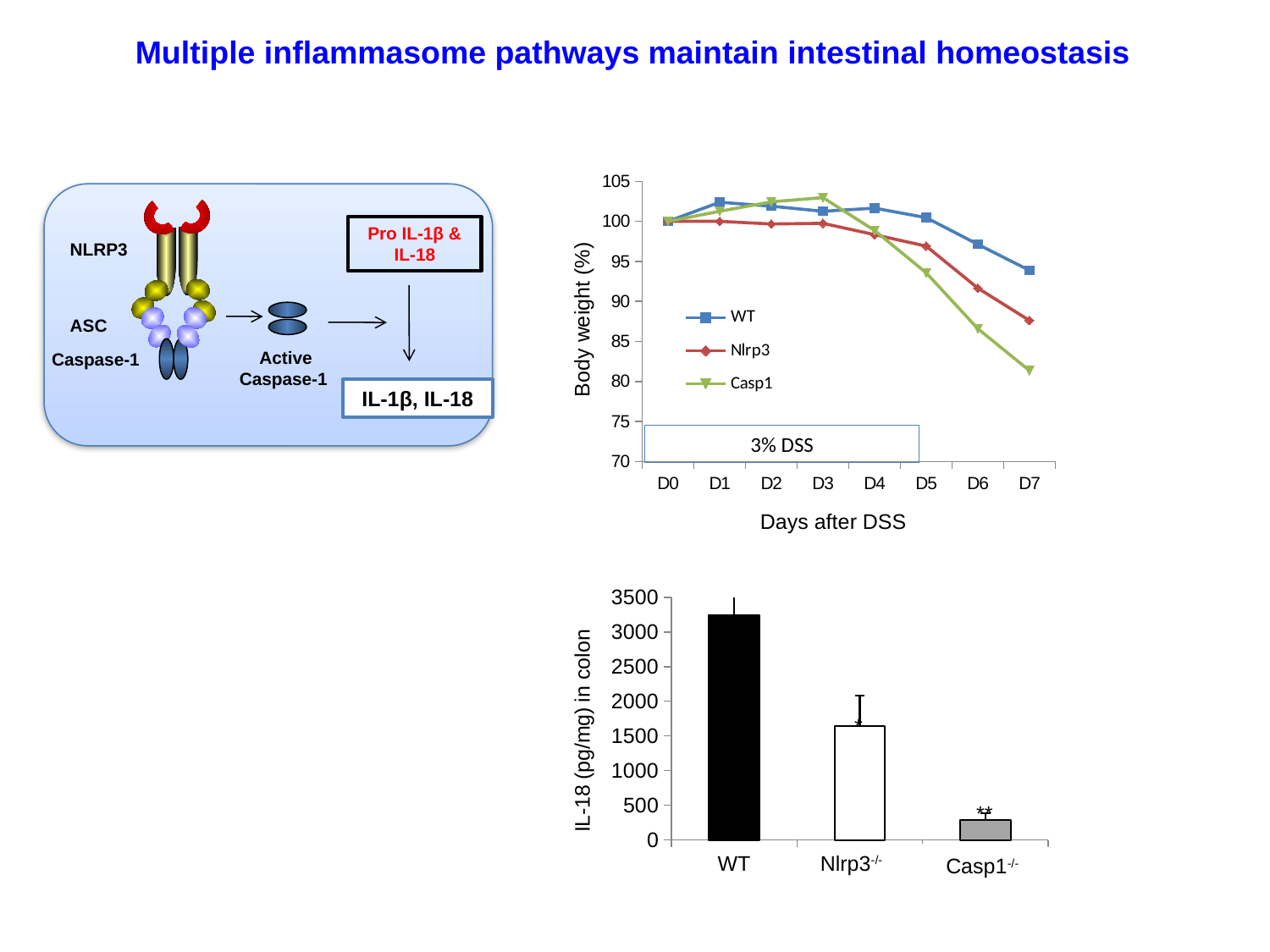
In the body weight chart (top right), does the Casp1 body weight rise or fall from D3 to D7? fall In the body weight chart (top right), how many time points are shown on the x axis? 8 In the body weight chart (top right), what is the label on the y axis? Body weight (%) What kind of chart is the IL-18 chart at the bottom right? bar chart In the body weight chart (top right), which series has the lowest body weight at D7? Casp1 In the IL-18 chart (bottom right), is the value for Casp1-/- greater or less than 500? less In the body weight chart (top right), how many series does the legend list? 3 In the IL-18 chart (bottom right), is the value for WT greater or less than 3000? greater In the IL-18 chart (bottom right), which category has the highest IL-18 level? WT In the IL-18 chart (bottom right), how many categories are shown? 3 In the body weight chart (top right), is the WT body weight at D7 greater or less than 90? greater